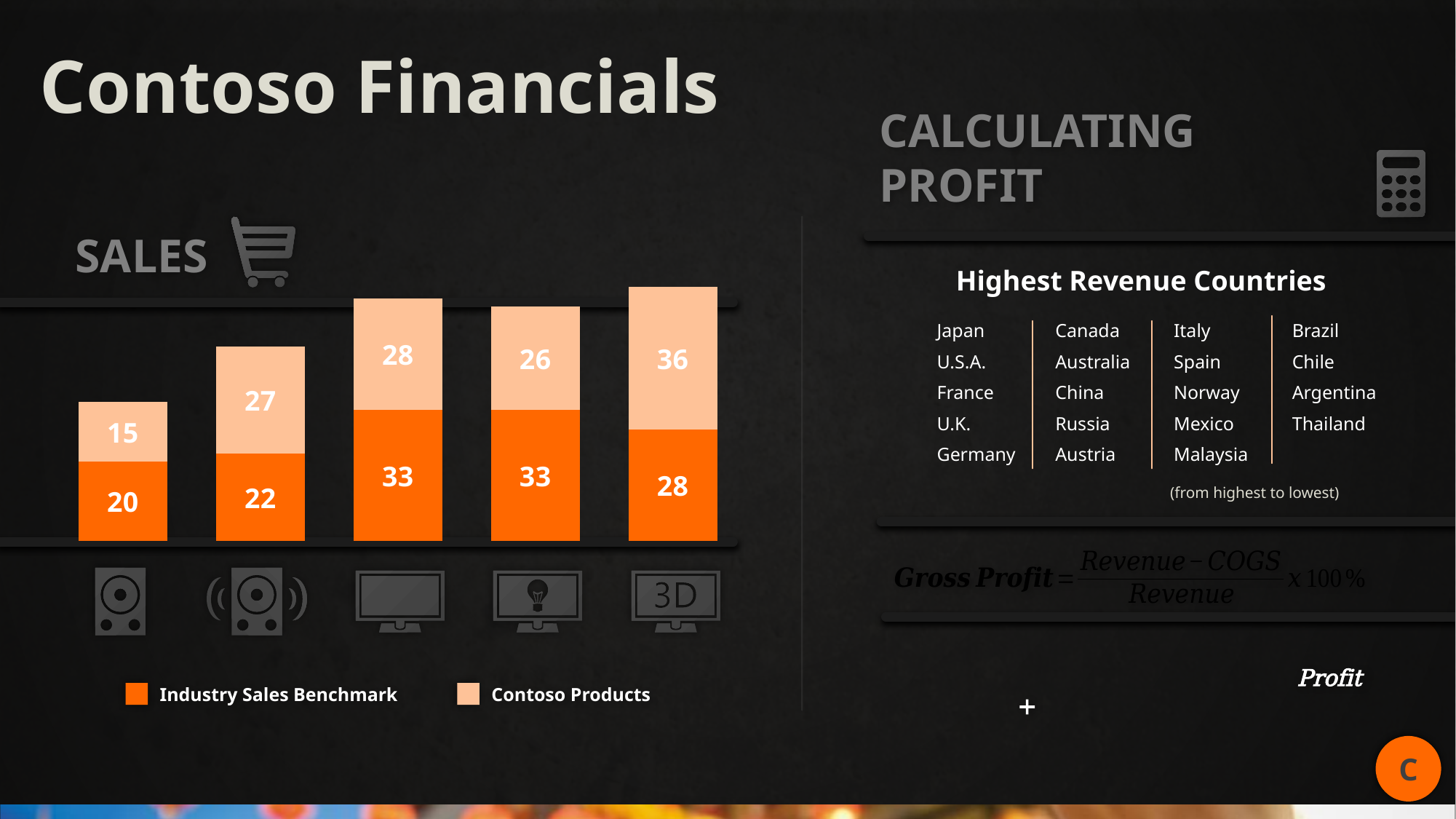
Which legend entry in the SALES chart is shown in the darker orange colour? Industry Sales Benchmark How many series does the legend of the SALES chart list? 2 What kind of chart is shown under the SALES heading? stacked bar chart In the SALES chart, what is the Industry Sales Benchmark value for the first bar from the left? 20 In the SALES chart, what is the difference between the Contoso Products value and the Industry Sales Benchmark value for the fifth bar from the left? 8 In the SALES chart, what is the total of the stacked third bar from the left? 61 How many bars are plotted in the SALES chart? 5 In the SALES chart, which bar has the lowest Industry Sales Benchmark value? the first bar In the SALES chart, what is the Contoso Products value for the second bar from the left? 27 In the SALES chart, which bar has the highest Contoso Products value? the fifth bar (3D icon) In the SALES chart, what is the Contoso Products value for the fifth bar from the left (the 3D icon)? 36 In the SALES chart, is the Industry Sales Benchmark value for the third bar larger or smaller than the Contoso Products value for the same bar? larger